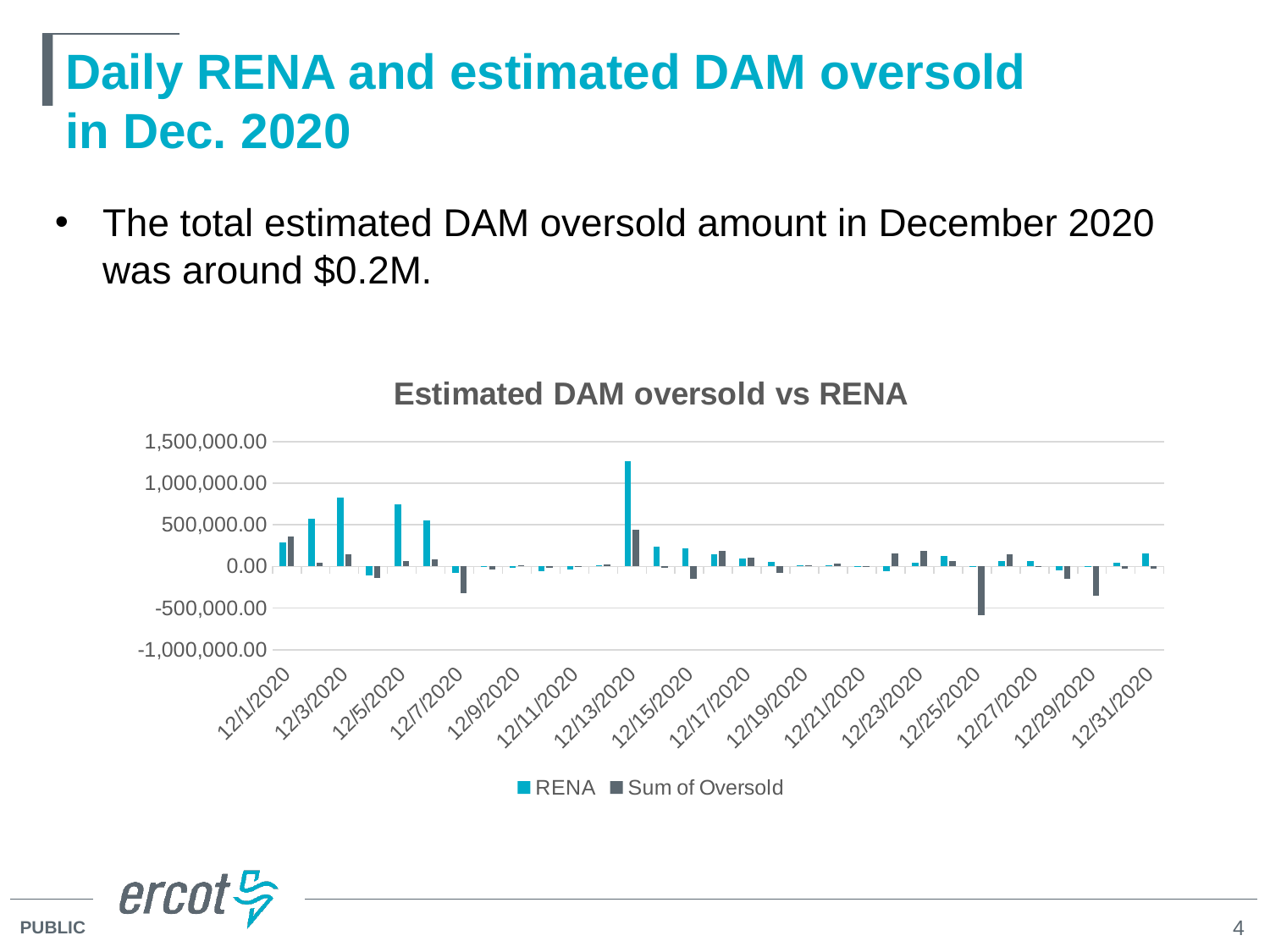
On which date does the Sum of Oversold series reach its lowest (most negative) value? 12/25/2020 How many date labels are shown along the x axis of the chart? 16 What is the title of the chart on the slide? Estimated DAM oversold vs RENA What are the two series named in the chart legend? RENA and Sum of Oversold Which date has the larger RENA value: 12/13/2020 or 12/3/2020? 12/13/2020 Is the Sum of Oversold value on 12/25/2020 greater or less than 0.00? less Is the RENA value on 12/3/2020 greater or less than 500,000.00? greater Is the RENA value on 12/13/2020 greater or less than 1,000,000.00? greater Which is larger on 12/13/2020: the RENA value or the Sum of Oversold value? RENA On which date does the RENA series reach its highest value? 12/13/2020 How many series does the legend of the chart list? 2 What kind of chart is 'Estimated DAM oversold vs RENA'? bar chart